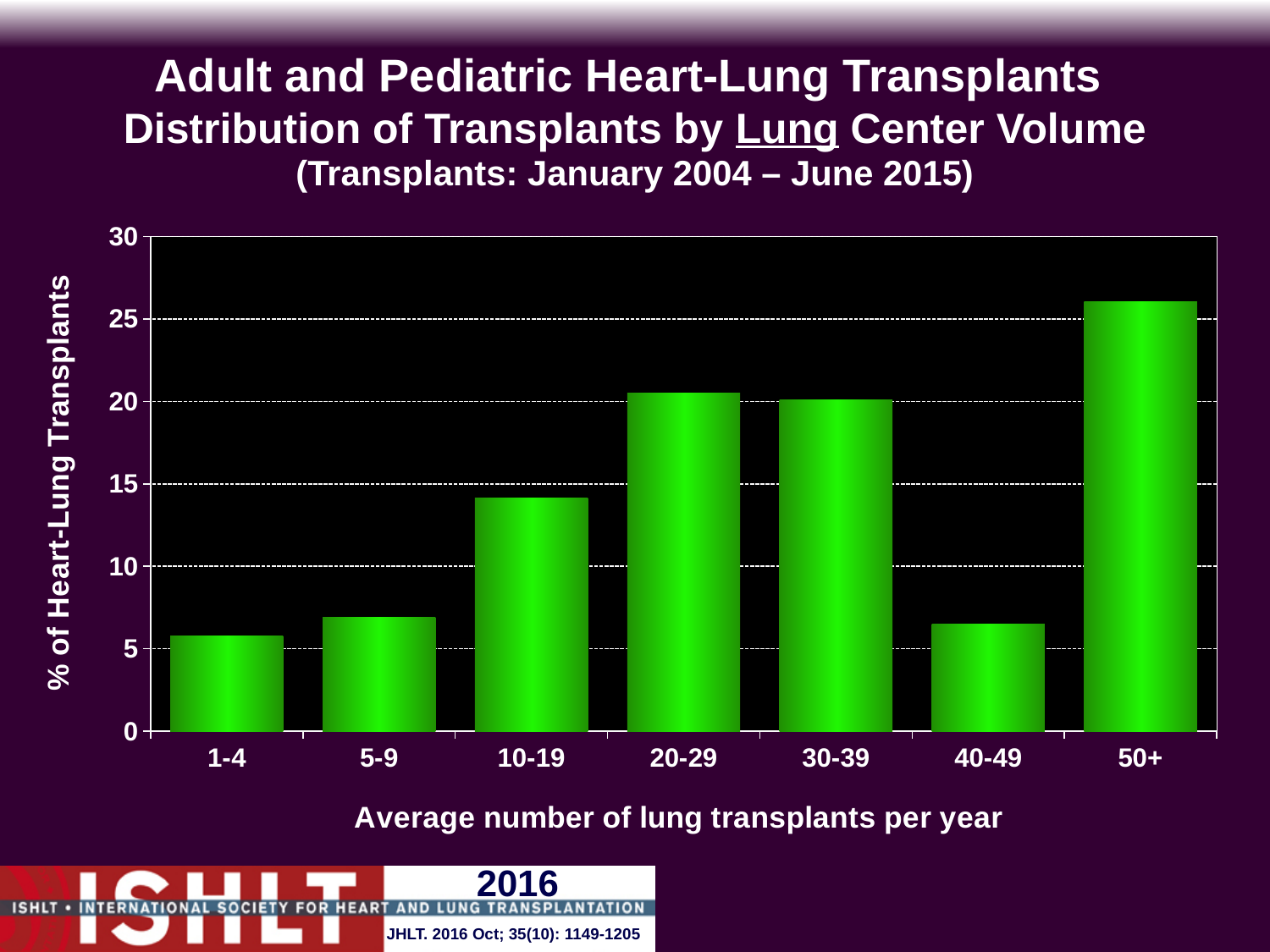
Which has a higher percentage of heart-lung transplants, the 20-29 category or the 40-49 category? 20-29 Is the value for the 20-29 category greater or less than 25? less Which has a higher percentage of heart-lung transplants, the 10-19 category or the 5-9 category? 10-19 What is the label of the y axis? % of Heart-Lung Transplants Is the value for the 10-19 category greater or less than 10? greater Is the value for the 10-19 category greater or less than 15? less What kind of chart is shown on the slide? bar chart Which center volume category has the highest percentage of heart-lung transplants? 50+ How many center volume categories are shown on the x axis? 7 What is the label of the x axis? Average number of lung transplants per year